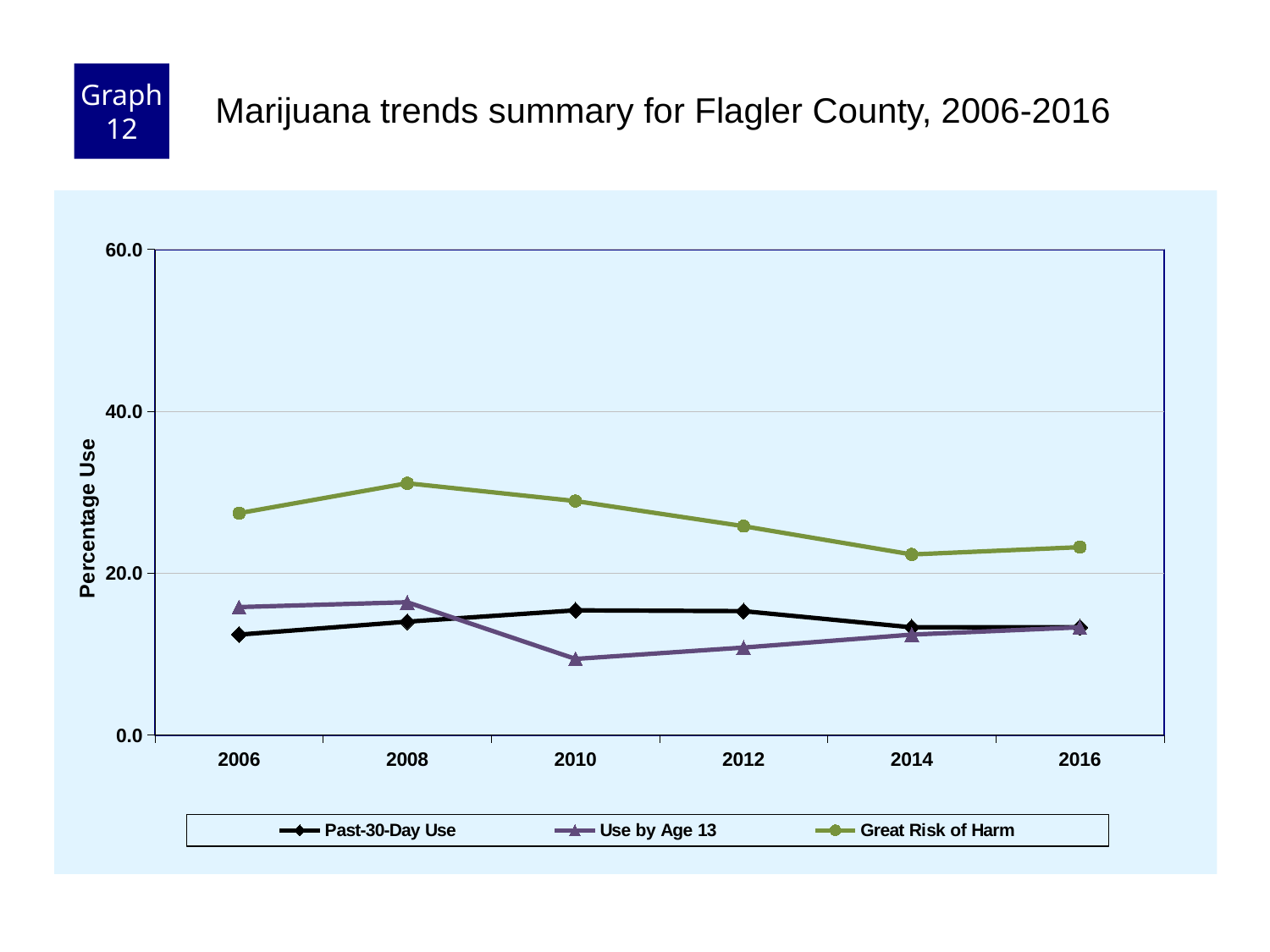
Is the value for Use by Age 13 in 2010 greater or less than 20.0? less How many years are plotted along the x axis? 6 In 2010, which is larger: Past-30-Day Use or Use by Age 13? Past-30-Day Use Does the Great Risk of Harm line rise or fall from 2008 to 2014? Fall In which year is the Great Risk of Harm value highest? 2008 In which year is the Use by Age 13 value lowest? 2010 Is the value for Great Risk of Harm in 2008 greater or less than 40.0? less Which series has the highest values across all years? Great Risk of Harm What is the label on the y axis? Percentage Use How many series does the legend list? 3 Is the value for Great Risk of Harm in 2008 greater or less than 20.0? greater What kind of chart is shown on the slide? Line chart